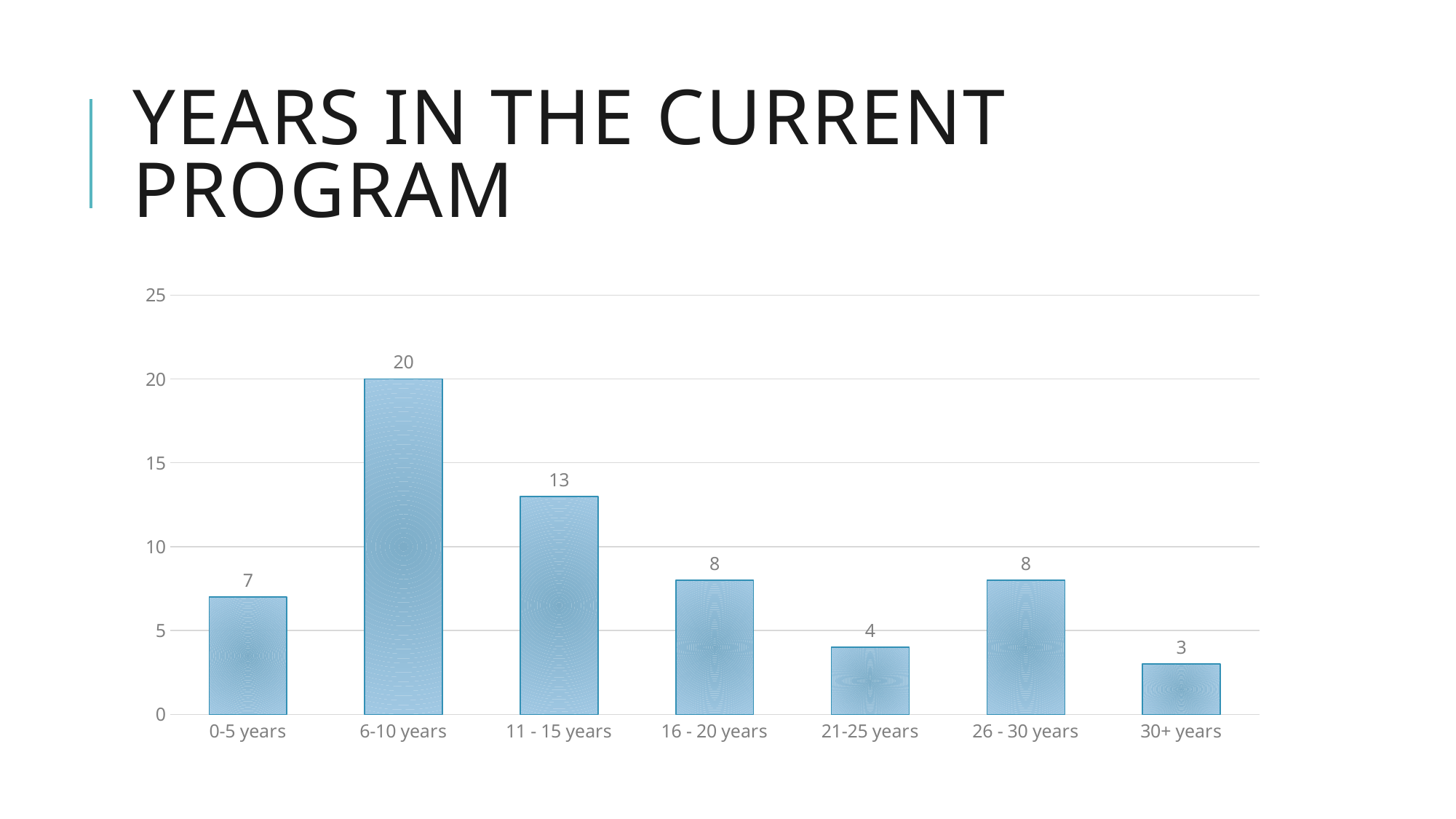
What is the value for 11 - 15 years? 13 What kind of chart is shown on the slide? bar chart Which is larger, the value for 0-5 years or the value for 21-25 years? 0-5 years What is the title of the slide? Years in the Current Program What is the value for 0-5 years? 7 Which category has the lowest value? 30+ years What is the difference between the values for 6-10 years and 11 - 15 years? 7 What is the value for 6-10 years? 20 What is the value for 30+ years? 3 Is the value for 11 - 15 years greater or less than 10? greater How many categories are shown on the x axis? 7 Which category has the highest value? 6-10 years